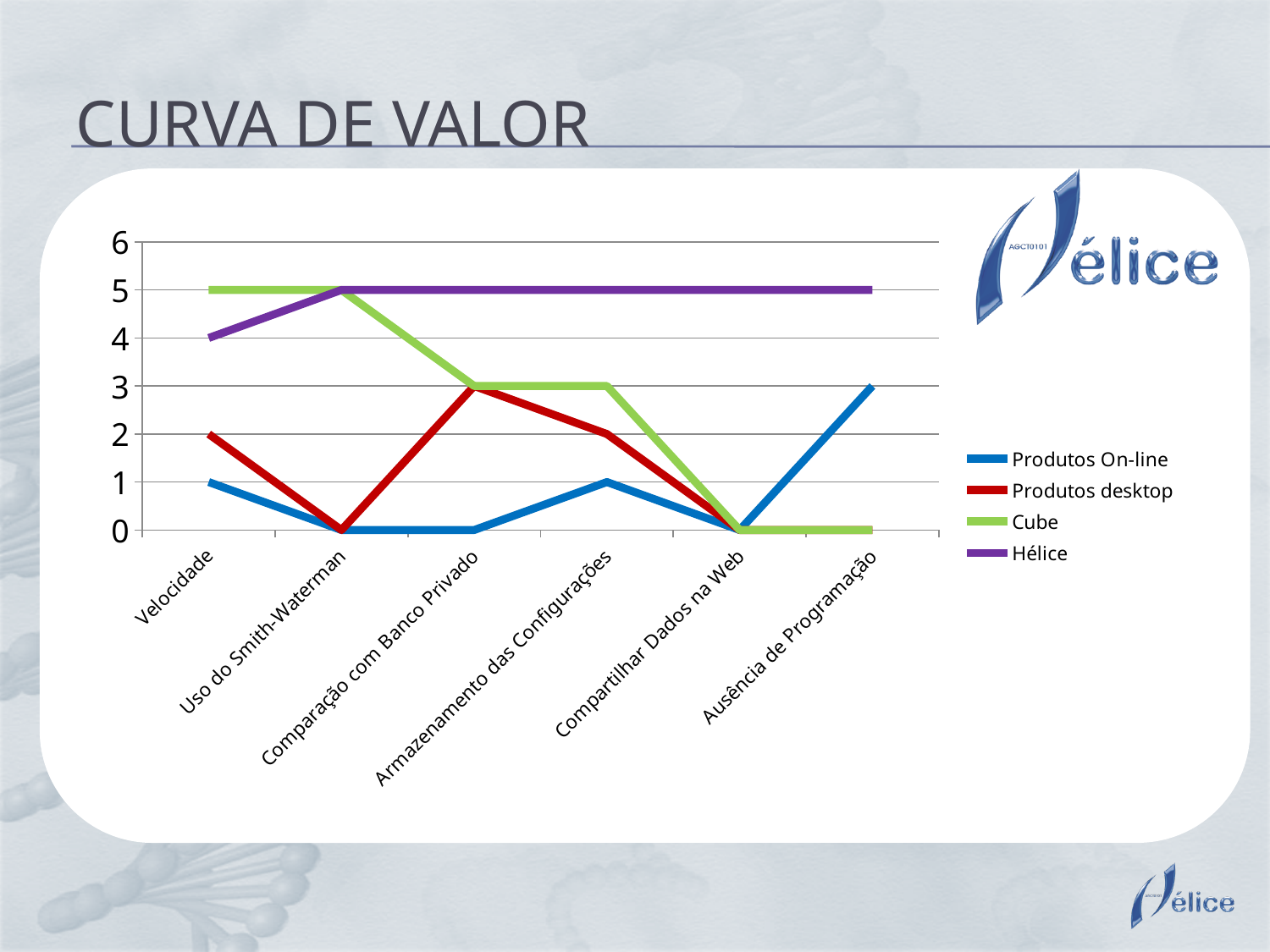
How many categories are shown on the x axis? 6 What is the value of Hélice for Velocidade? 4 Does the Cube series rise or fall from Uso do Smith-Waterman to Compartilhar Dados na Web? fall What is the value of Produtos desktop for Armazenamento das Configurações? 2 Which series has the highest value for Compartilhar Dados na Web? Hélice What is the difference between Hélice and Produtos On-line for Velocidade? 3 What is the title of the slide containing the chart? CURVA DE VALOR What is the value of Produtos On-line for Ausência de Programação? 3 What kind of chart is shown on the slide? line chart What is the value of Cube for Comparação com Banco Privado? 3 Which is larger for Velocidade, Cube or Produtos desktop? Cube How many series does the legend list? 4